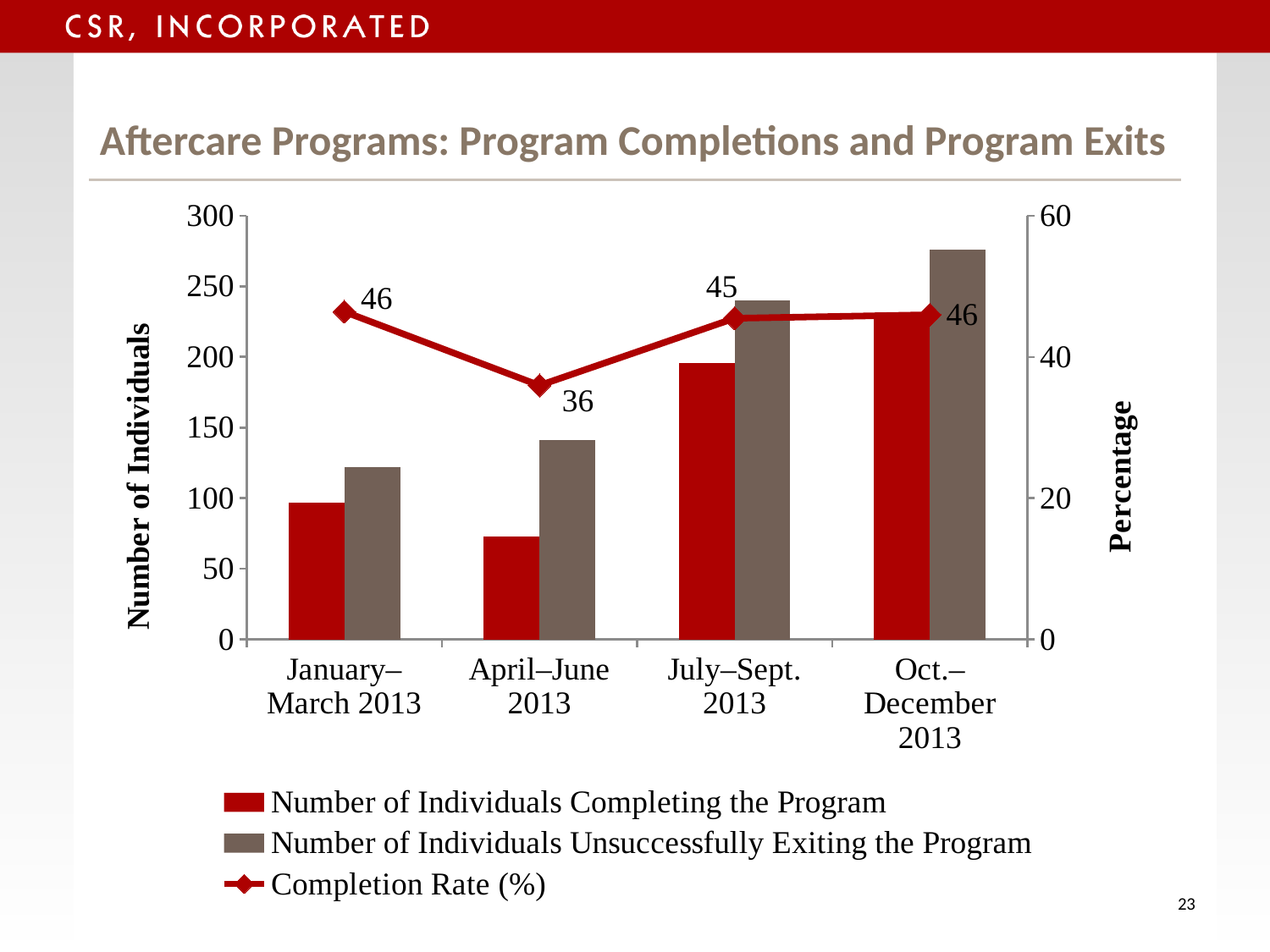
Which quarter has the lowest Number of Individuals Completing the Program? April–June 2013 What is the Completion Rate (%) for July–Sept. 2013? 45 Does the Number of Individuals Unsuccessfully Exiting the Program rise or fall across the quarters from January–March 2013 to Oct.–December 2013? rise Which quarter has the highest Number of Individuals Unsuccessfully Exiting the Program? Oct.–December 2013 Is the Number of Individuals Unsuccessfully Exiting the Program in Oct.–December 2013 greater or less than 250? greater Is the Number of Individuals Completing the Program in April–June 2013 greater or less than 100? less What is the Completion Rate (%) for April–June 2013? 36 How many quarters are shown on the x axis? 4 In July–Sept. 2013, which is larger: the Number of Individuals Completing the Program or the Number of Individuals Unsuccessfully Exiting the Program? Number of Individuals Unsuccessfully Exiting the Program How many series does the legend list? 3 Which quarter has the lowest Completion Rate (%)? April–June 2013 By how many percentage points does the Completion Rate for January–March 2013 exceed that for April–June 2013? 10